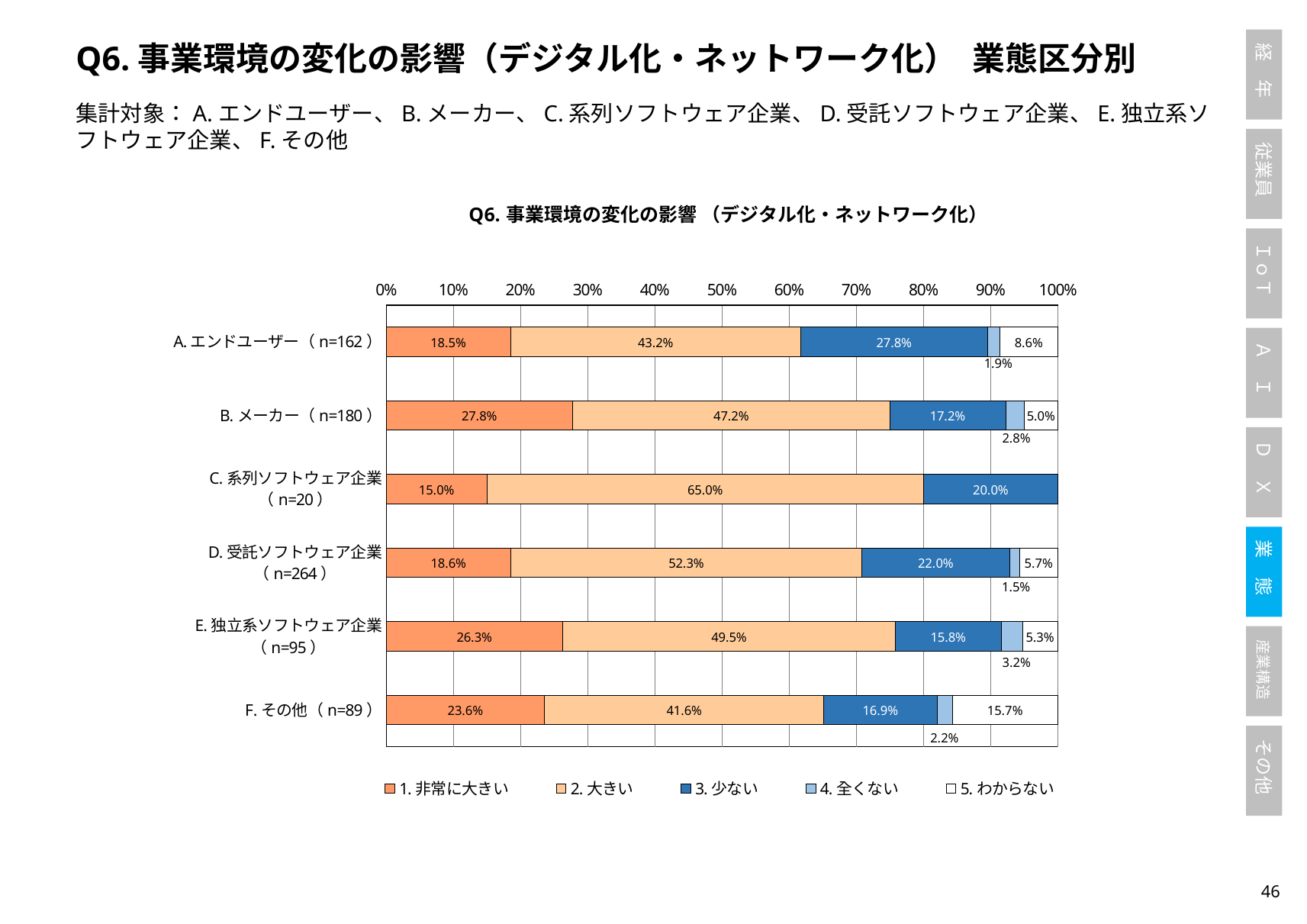
How many percentage points higher is the 1. 非常に大きい share for B. メーカー than for A. エンドユーザー? 9.3 What is the sample size (n) shown for D. 受託ソフトウェア企業? 264 How many series does the legend list? 5 Which category has the lowest share of 1. 非常に大きい responses? C. 系列ソフトウェア企業 How many business categories are shown in the chart? 6 What percentage of F. その他 respondents answered 5. わからない? 15.7% Which category has the highest share of 2. 大きい responses? C. 系列ソフトウェア企業 What is the value for 4. 全くない in the E. 独立系ソフトウェア企業 bar? 3.2% Which has a larger 3. 少ない share, A. エンドユーザー or B. メーカー? A. エンドユーザー What percentage of A. エンドユーザー respondents answered 2. 大きい? 43.2% What is the value for 3. 少ない in the D. 受託ソフトウェア企業 bar? 22.0% What type of chart is shown on the slide? Stacked bar chart